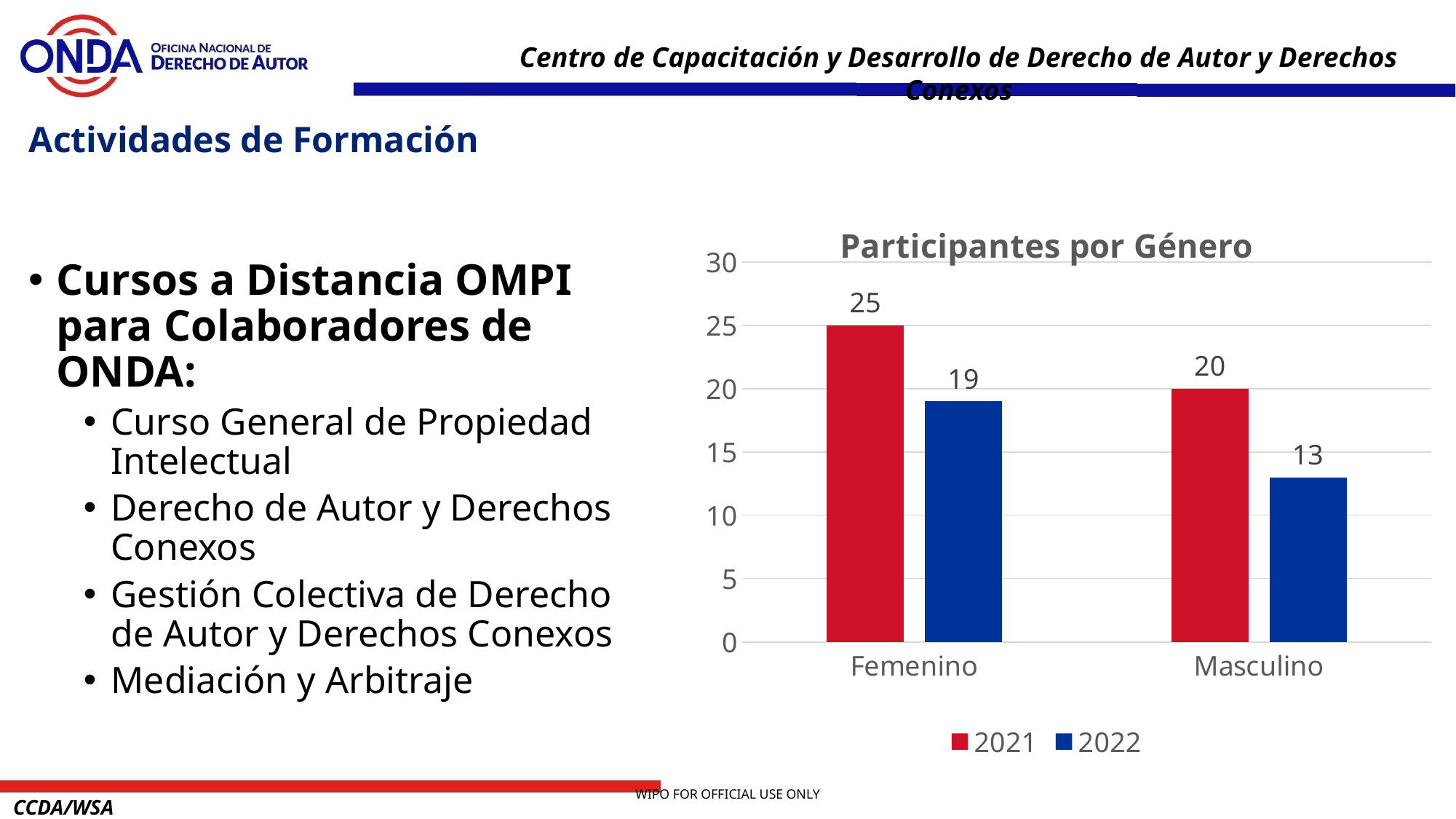
Which category has the lowest value in the 2022 series? Masculino How many series does the legend list? 2 What is the difference between the 2021 and 2022 values for Masculino? 7 What is the value for Masculino in 2022? 13 Is the 2022 value for Masculino greater or less than 15? less How many categories are shown on the x axis? 2 What is the title of the chart? Participantes por Género What is the value for Femenino in 2021? 25 What kind of chart is shown? bar chart What is the value for Femenino in 2022? 19 Which category has the highest value in the 2021 series? Femenino Which is larger: the 2022 value for Femenino or the 2021 value for Masculino? Masculino 2021